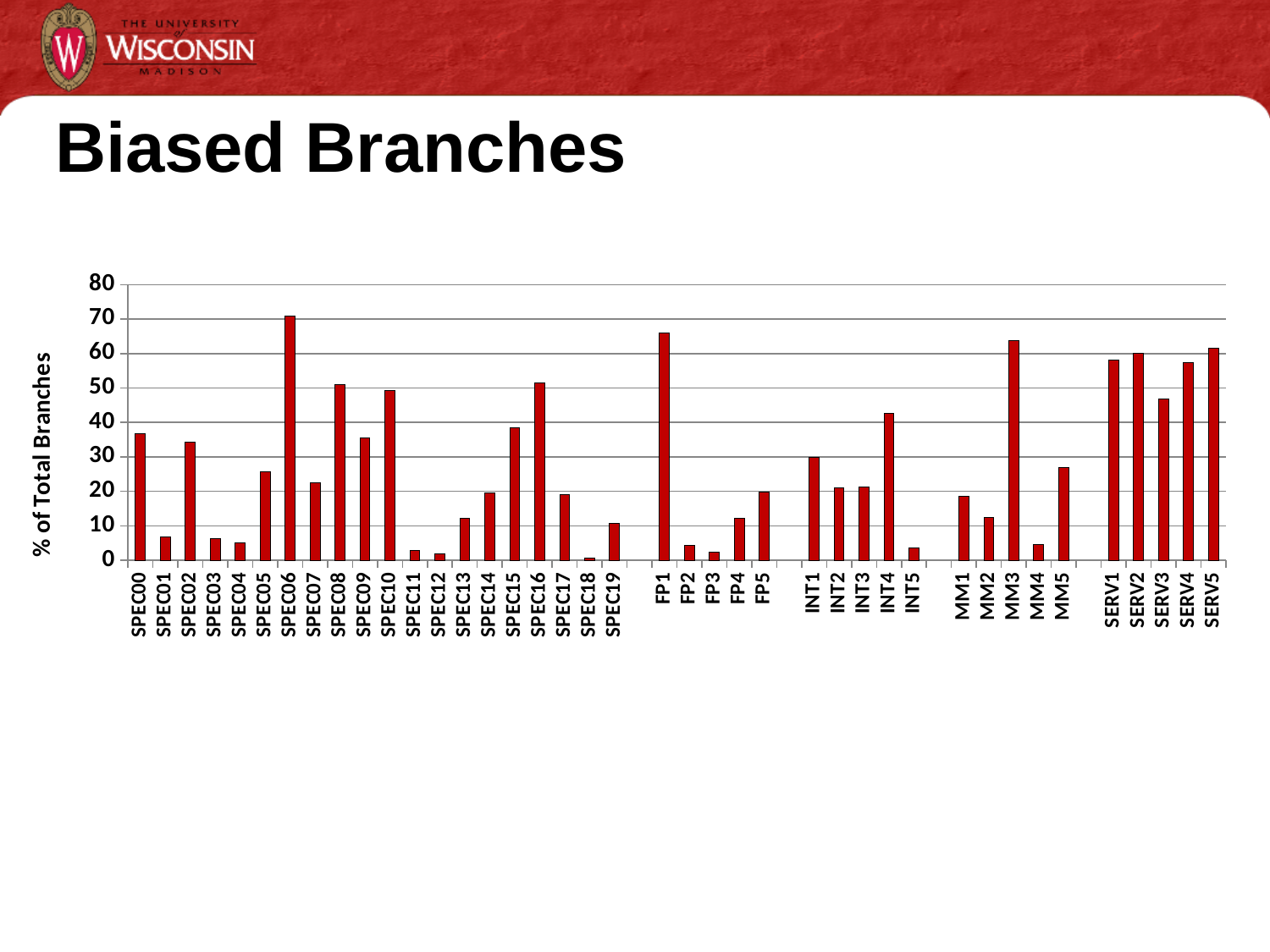
Is the value for SPEC02 greater or less than 30? greater Is the value for FP1 greater or less than 60? greater Is the value for MM3 greater or less than 60? greater Which is larger, the value for SPEC06 or the value for FP1? SPEC06 Which category has the highest value? SPEC06 Which is larger, the value for INT4 or the value for INT5? INT4 Which category has the lowest value? SPEC18 What kind of chart is shown on the slide? bar chart What is the label on the vertical axis of the chart? % of Total Branches How many bars are plotted in the chart? 40